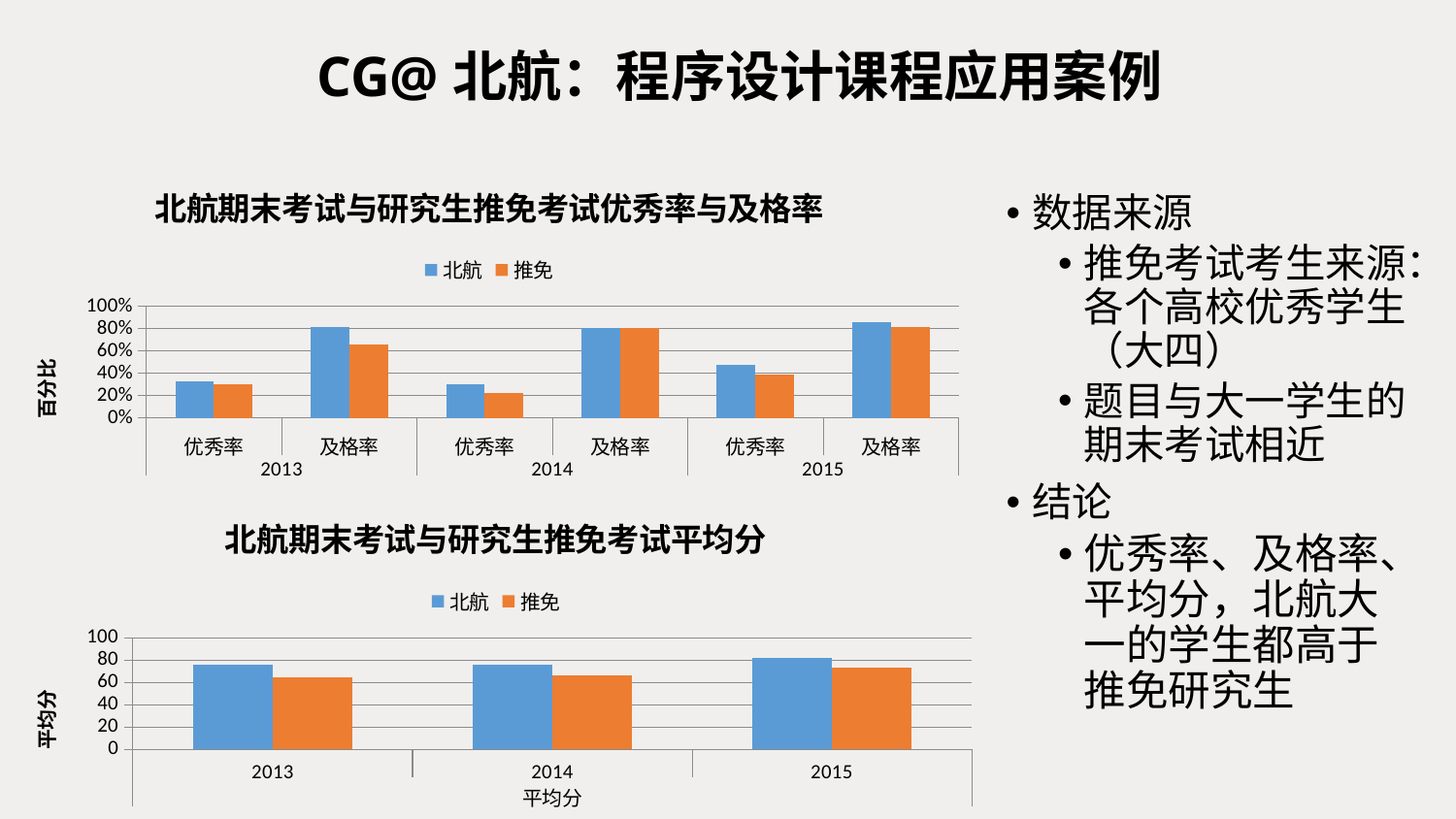
What type of chart is the top chart titled 北航期末考试与研究生推免考试优秀率与及格率? bar chart In the top chart (优秀率与及格率), is the 北航 value for 优秀率 in 2015 greater or less than 40%? greater In the top chart (优秀率与及格率), which bar is the lowest overall? 推免 优秀率 in 2014 In the top chart (优秀率与及格率), is the 北航 value for 优秀率 in 2013 greater or less than 20%? greater In the bottom chart (平均分), is the 北航 value for 2013 greater or less than 60? greater What is the y-axis label of the bottom chart (平均分)? 平均分 In the bottom chart (平均分), how many year categories are shown on the x axis? 3 How many series does the legend of the bottom chart (北航期末考试与研究生推免考试平均分) list? 2 In the top chart (优秀率与及格率), which is larger for 优秀率 in 2015: 北航 or 推免? 北航 In the bottom chart (平均分), which year has the highest 北航 value? 2015